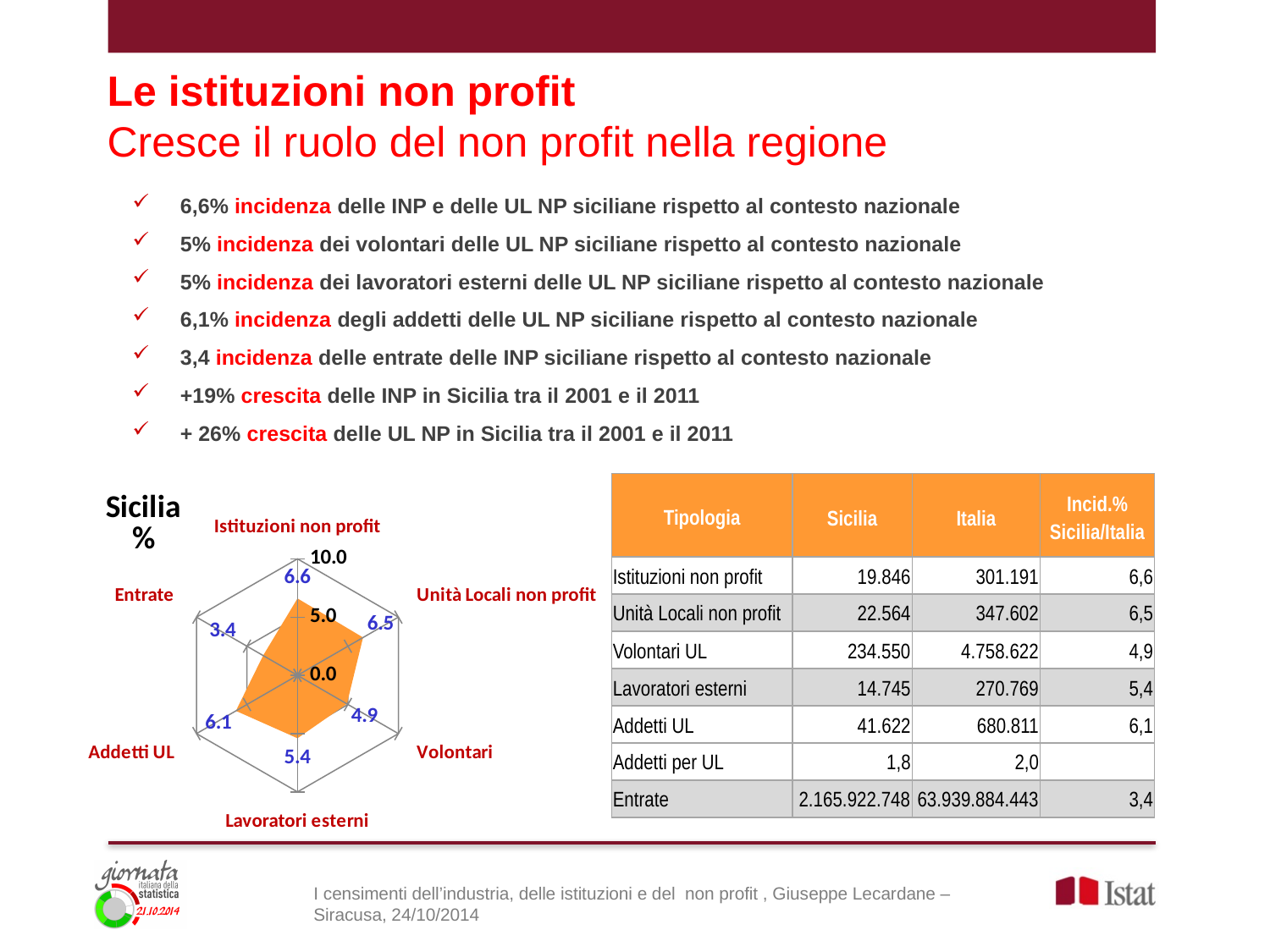
In the radar chart, which category has the lowest value? Entrate In the radar chart, which is larger, the value for Addetti UL or the value for Volontari? Addetti UL In the radar chart, what is the value for Istituzioni non profit? 6.6 In the radar chart, what is the value for Volontari? 4.9 In the radar chart, what is the value for Addetti UL? 6.1 In the radar chart, what is the difference between the values for Istituzioni non profit and Entrate? 3.2 In the radar chart, what is the value for Lavoratori esterni? 5.4 In the radar chart, is the value for Entrate greater or less than 5.0? less How many categories does the radar chart show? 6 In the radar chart, what is the value for Entrate? 3.4 What kind of chart is shown on the slide? radar chart In the radar chart, what is the difference between the values for Addetti UL and Volontari? 1.2